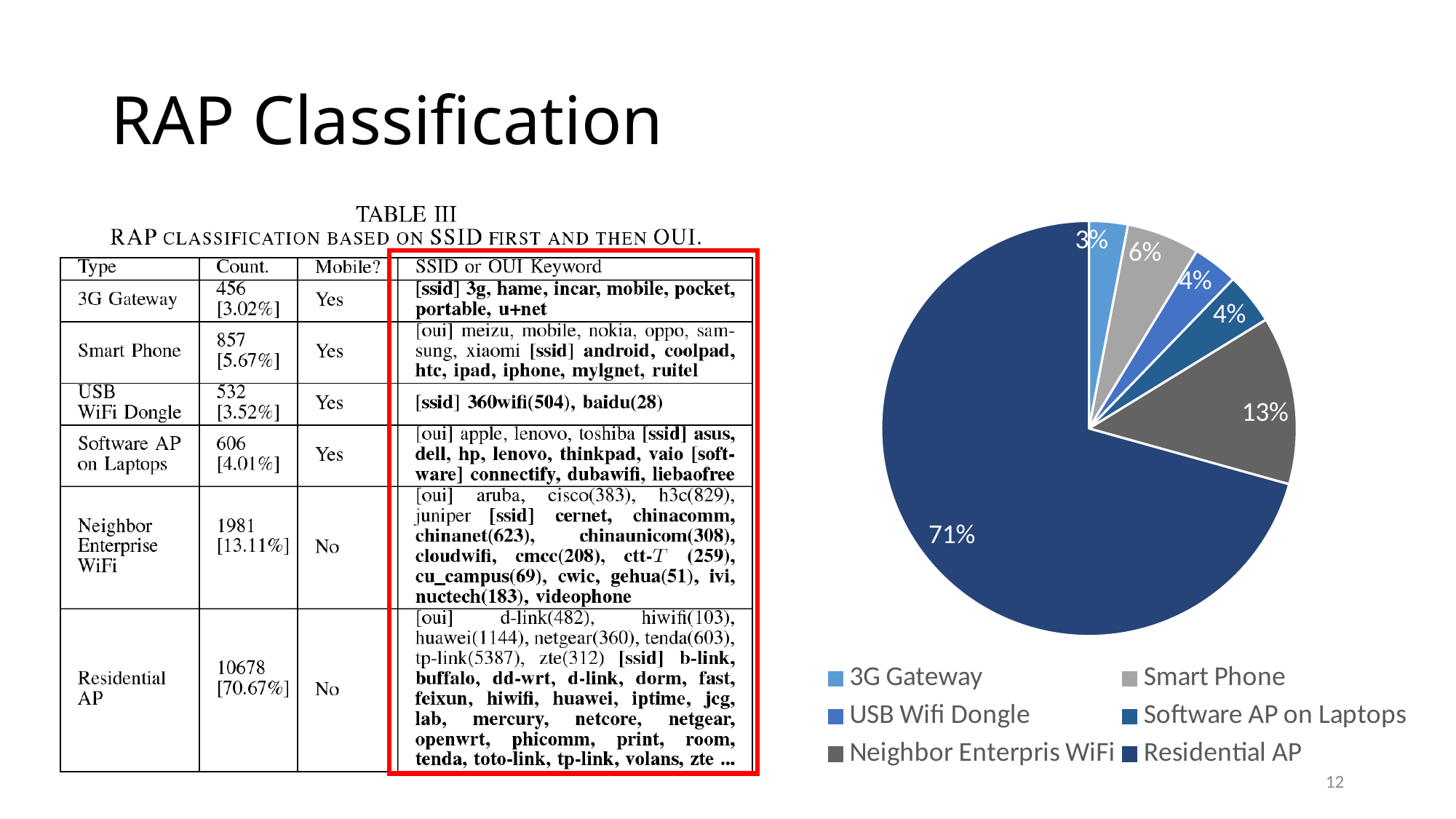
In the pie chart, what percentage is shown for Smart Phone? 6% Which category has the smallest slice in the pie chart? 3G Gateway Which category has the largest slice in the pie chart? Residential AP What type of chart is shown on the right side of the slide? Pie chart In the pie chart, how many percentage points larger is Residential AP than Neighbor Enterpris WiFi? 58 In the pie chart, what percentage is shown for USB Wifi Dongle? 4% In the pie chart, what percentage is shown for Residential AP? 71% What colour is the Residential AP slice in the pie chart? Dark blue (navy) How many categories does the pie chart's legend list? 6 In the pie chart, what percentage is shown for Neighbor Enterpris WiFi? 13% In the pie chart, what percentage is shown for 3G Gateway? 3% In the pie chart, which is larger: Smart Phone or 3G Gateway? Smart Phone